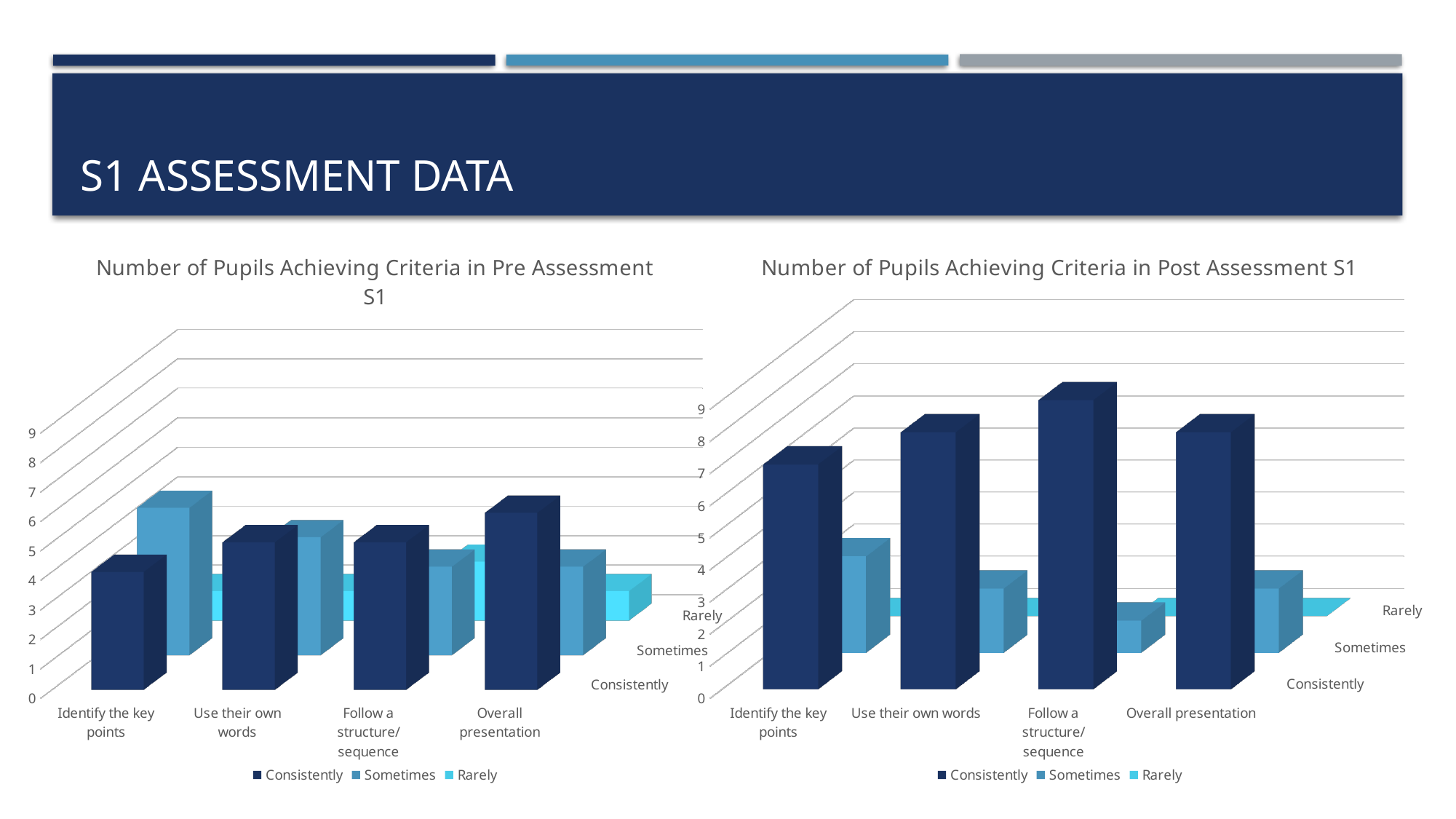
In the 'Number of Pupils Achieving Criteria in Pre Assessment S1' chart, which category has the highest Consistently value? Overall presentation Which series is shown in the darkest blue in the legend of the 'Number of Pupils Achieving Criteria in Post Assessment S1' chart? Consistently In the 'Number of Pupils Achieving Criteria in Pre Assessment S1' chart, for Identify the key points, which is larger: the Consistently value or the Sometimes value? Sometimes How many categories are shown on the x axis of the 'Number of Pupils Achieving Criteria in Pre Assessment S1' chart? 4 In the 'Number of Pupils Achieving Criteria in Post Assessment S1' chart, which category has the highest Consistently value? Follow a structure/ sequence In the 'Number of Pupils Achieving Criteria in Post Assessment S1' chart, is the Consistently value for Follow a structure/ sequence greater or less than 5? greater What type of chart is the 'Number of Pupils Achieving Criteria in Pre Assessment S1' chart? Bar chart In the 'Number of Pupils Achieving Criteria in Post Assessment S1' chart, which category has the lowest Consistently value? Identify the key points How many series does the legend list on the 'Number of Pupils Achieving Criteria in Post Assessment S1' chart? 3 In the 'Number of Pupils Achieving Criteria in Post Assessment S1' chart, is the Sometimes value for Follow a structure/ sequence greater or less than 3? less In the 'Number of Pupils Achieving Criteria in Pre Assessment S1' chart, which category has the lowest Consistently value? Identify the key points In the 'Number of Pupils Achieving Criteria in Pre Assessment S1' chart, is the Consistently value for Identify the key points greater or less than 6? less